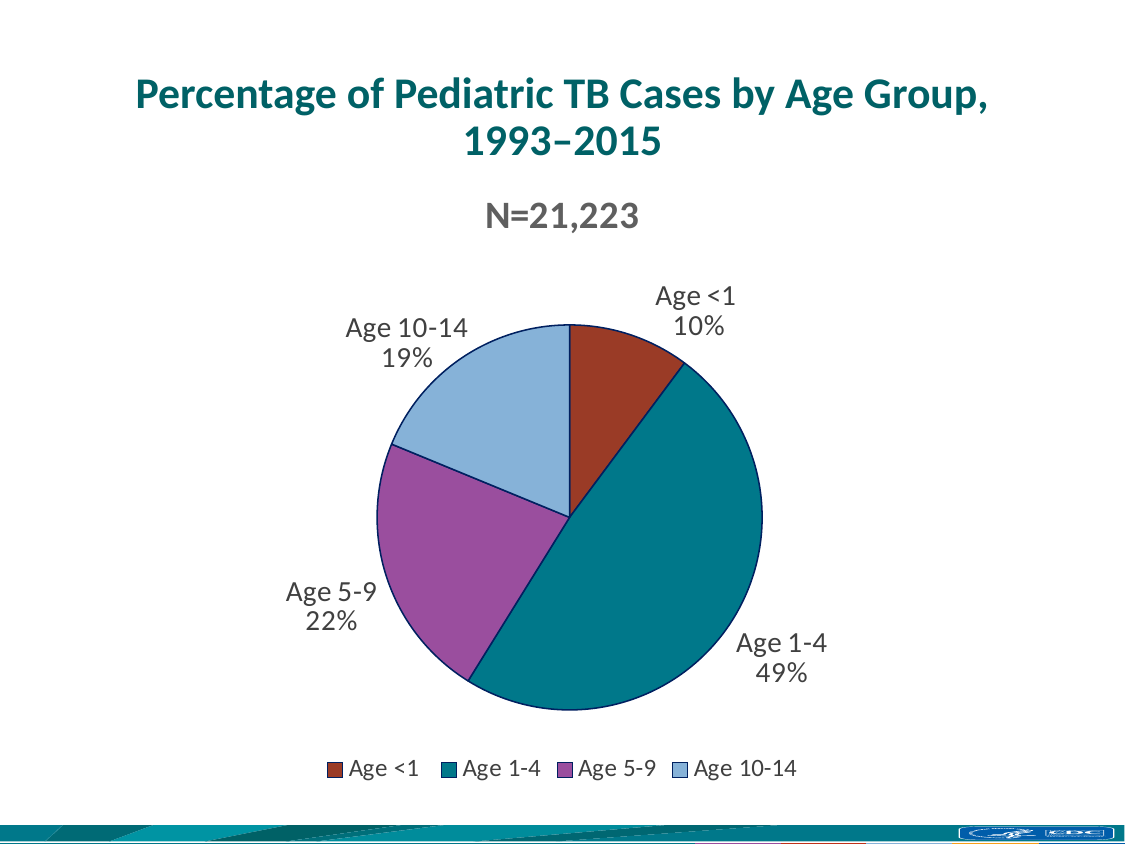
What is the total number of cases (N) stated on the slide? N=21,223 What percentage of pediatric TB cases is shown for Age 10-14? 19% What is the difference in percentage points between the Age 1-4 and Age 5-9 slices? 27 What percentage of pediatric TB cases is shown for Age 1-4? 49% How many age groups are shown in the pie chart? 4 What percentage of pediatric TB cases is shown for Age <1? 10% What percentage of pediatric TB cases is shown for Age 5-9? 22% Which age group has the smallest share of pediatric TB cases? Age <1 Which slice is larger, Age 5-9 or Age 10-14? Age 5-9 What type of chart is shown on the slide? pie chart Which age group has the largest share of pediatric TB cases? Age 1-4 What is the title of the chart? Percentage of Pediatric TB Cases by Age Group, 1993–2015